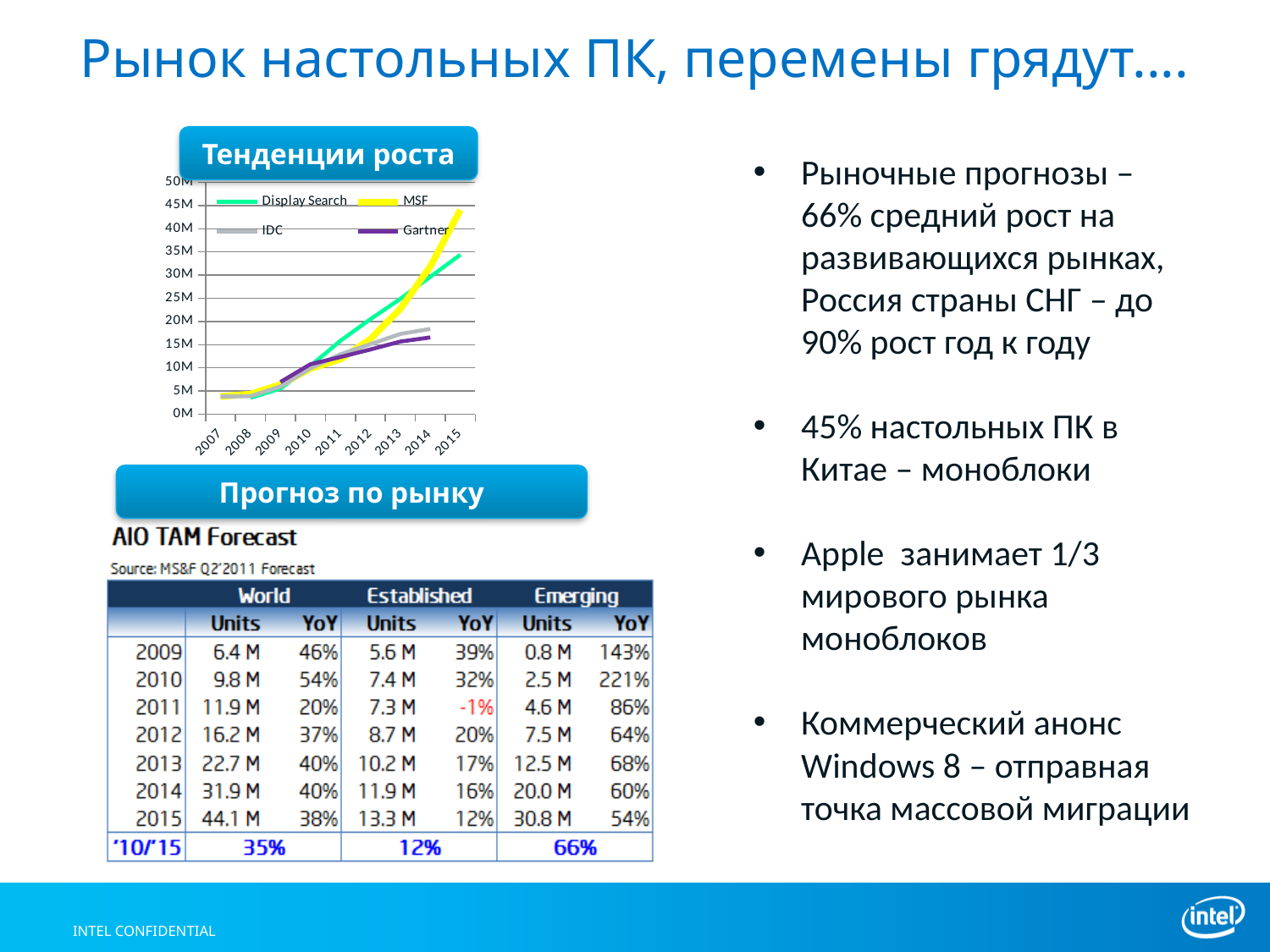
Which series are listed in the legend of the "Тенденции роста" chart? Display Search, MSF, IDC, Gartner What is the highest value shown on the y axis of the "Тенденции роста" chart? 50M In the "Тенденции роста" chart, do the values for the MSF series rise or fall from 2007 to 2015? rise In the "Тенденции роста" chart, is the IDC value for 2014 greater or less than 20M? less In the "Тенденции роста" chart, is the Gartner value for 2014 greater or less than 20M? less How many years are shown on the x axis of the "Тенденции роста" chart? 9 In the "Тенденции роста" chart, is the Display Search value for 2015 greater or less than 30M? greater In the "Тенденции роста" chart, which series has the highest value in 2015? MSF What kind of chart is the "Тенденции роста" chart? line chart In the "Тенденции роста" chart, which is larger in 2014: the Display Search value or the Gartner value? Display Search How many series does the legend of the "Тенденции роста" chart list? 4